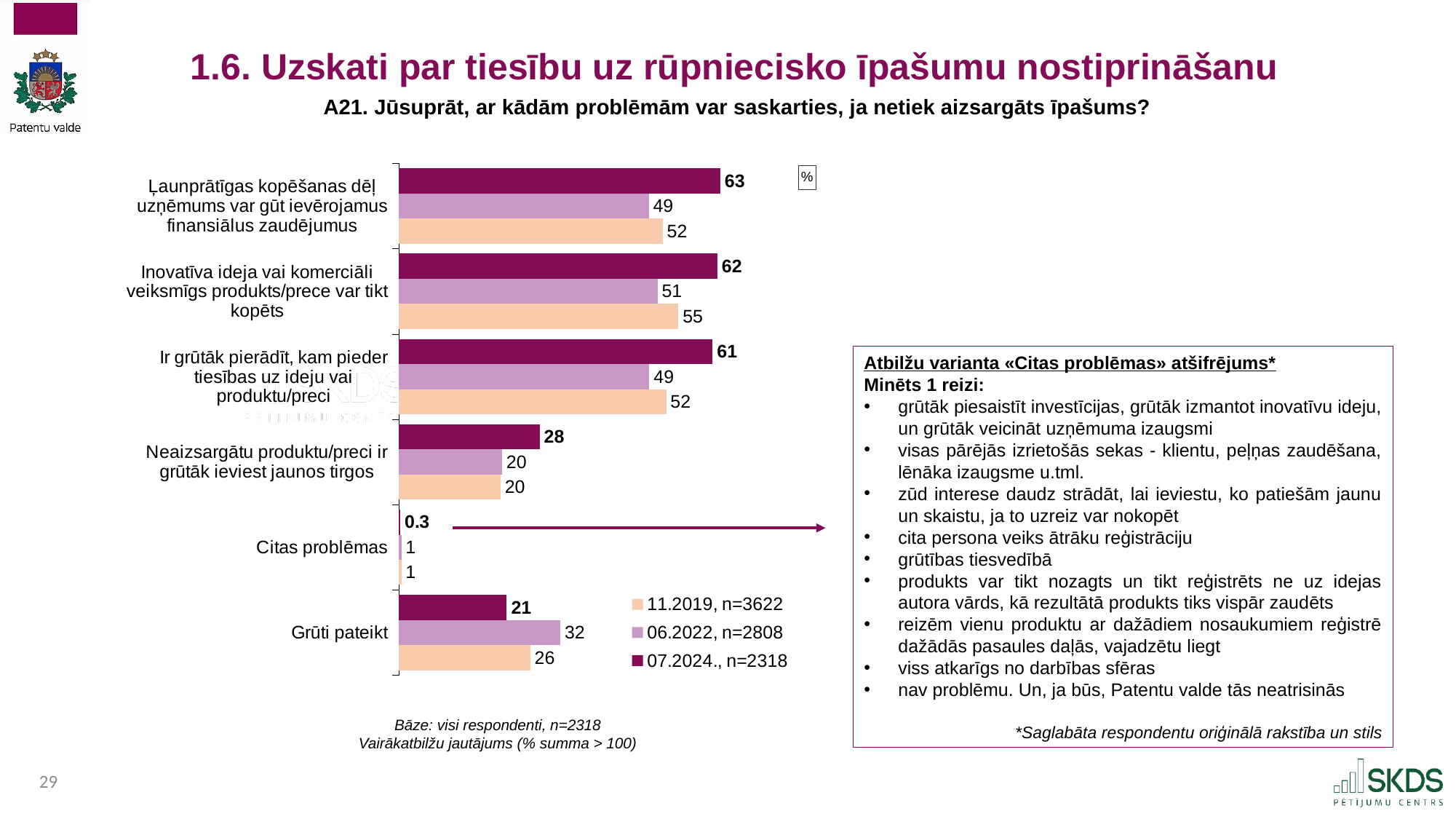
What is the 07.2024 value for "Citas problēmas"? 0.3 For "Grūti pateikt", which is larger: the 11.2019 value or the 07.2024 value? 11.2019 How many series does the legend list? 3 What is the 07.2024 value for "Ļaunprātīgas kopēšanas dēļ uzņēmums var gūt ievērojamus finansiālus zaudējumus"? 63 What is the 06.2022 value for "Grūti pateikt"? 32 What is the 11.2019 value for "Inovatīva ideja vai komerciāli veiksmīgs produkts/prece var tikt kopēts"? 55 What type of chart is shown on the slide? Bar chart What is the sample size (n) shown in the legend for the 06.2022 series? n=2808 How many categories are shown on the chart? 6 Which category has the lowest 06.2022 value? Citas problēmas What is the difference between the 07.2024 and 06.2022 values for "Ir grūtāk pierādīt, kam pieder tiesības uz ideju vai produktu/preci"? 12 Which category has the highest 07.2024 value? Ļaunprātīgas kopēšanas dēļ uzņēmums var gūt ievērojamus finansiālus zaudējumus